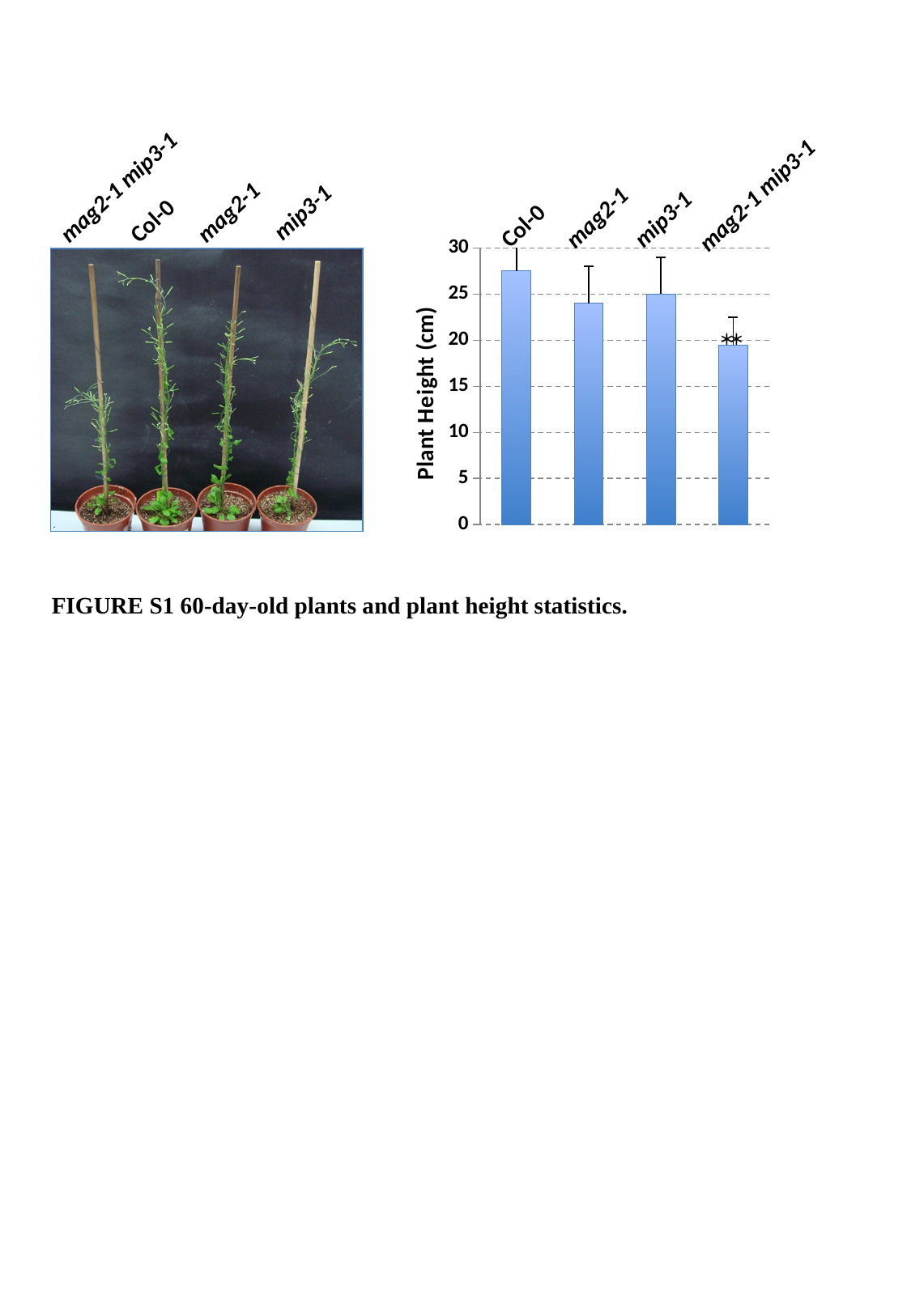
What kind of chart is shown on the slide? bar chart Which plant line has the greatest plant height in the bar chart? Col-0 Which plant line has the lowest plant height in the bar chart? mag2-1 mip3-1 Which bar in the chart is marked with asterisks (**)? mag2-1 mip3-1 Is the plant height for mag2-1 mip3-1 greater or less than 15 cm? greater Which has the greater plant height, Col-0 or mag2-1? Col-0 How many categories (plant lines) are plotted in the bar chart? 4 Is the plant height for mag2-1 mip3-1 greater or less than 25 cm? less Is the plant height for mag2-1 greater or less than 20 cm? greater Which has the greater plant height, Col-0 or mag2-1 mip3-1? Col-0 What is the label of the y-axis in the bar chart? Plant Height (cm)